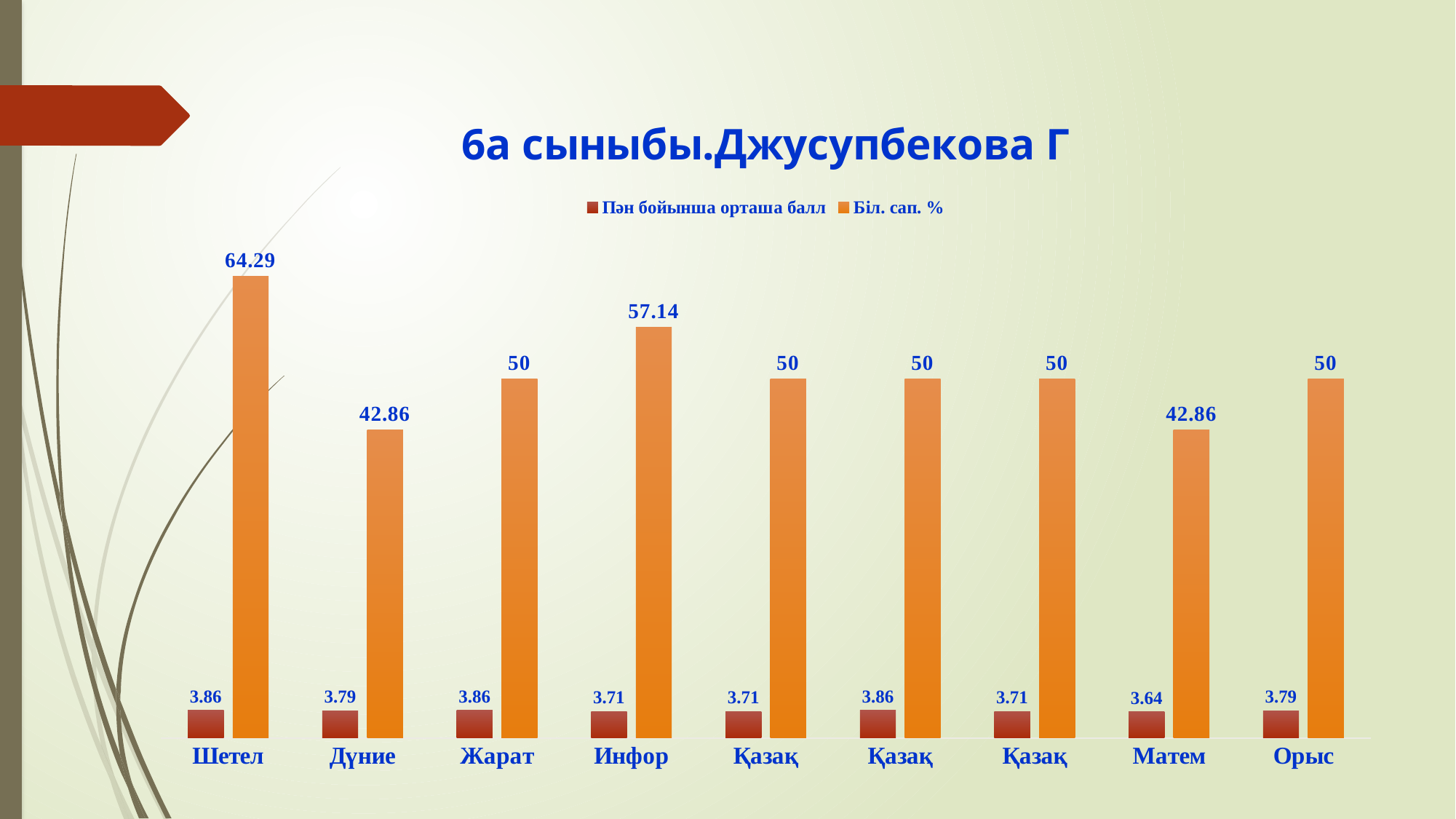
What is the value of "Біл. сап. %" for Инфор? 57.14 What is the value of "Біл. сап. %" for Шетел? 64.29 What is the difference between the "Біл. сап. %" values for Шетел and Дүние? 21.43 Which has a larger "Біл. сап. %" value, Инфор or Жарат? Инфор How many series does the legend list? 2 Which category has the lowest value of "Пән бойынша орташа балл"? Матем What is the value of "Пән бойынша орташа балл" for Матем? 3.64 What kind of chart is shown on the slide? Bar chart What is the value of "Пән бойынша орташа балл" for Орыс? 3.79 What is the title of the slide? 6а сыныбы.Джусупбекова Г Which category has the highest value of "Біл. сап. %"? Шетел How many categories are shown on the x axis? 9